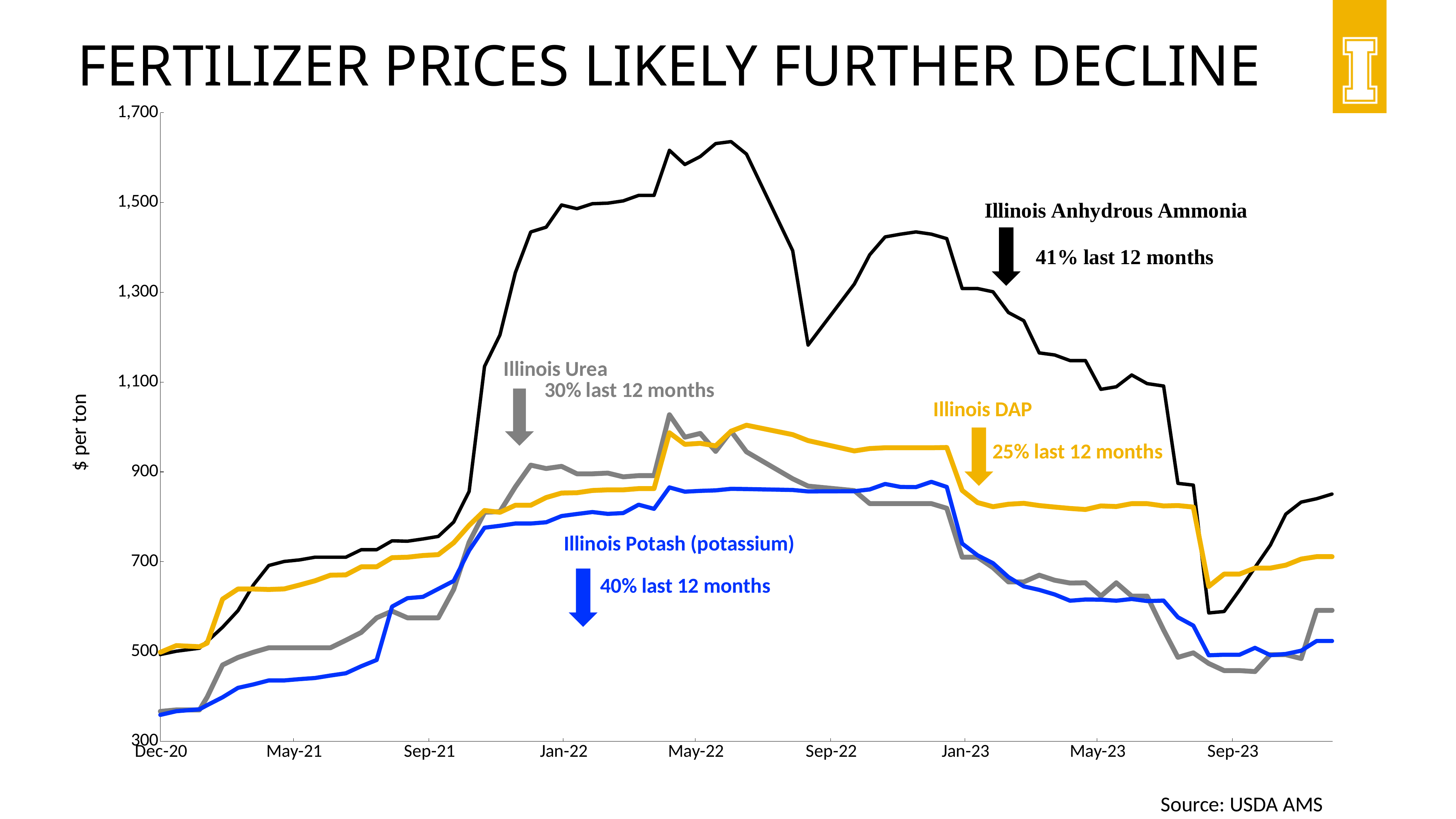
Does the Illinois Anhydrous Ammonia price rise or fall from Jan-23 to Sep-23? fall How many fertilizer price series are plotted on the chart? 4 At Dec-20, which is higher, Illinois DAP or Illinois Potash (potassium)? Illinois DAP What kind of chart is shown on the slide? line chart Is the Illinois Anhydrous Ammonia price at May-22 greater or less than 1,500? greater Is the Illinois DAP price at May-22 greater or less than 900? greater What percentage decline over the last 12 months is annotated for Illinois Potash (potassium)? 40% Which series reaches the highest price on the chart? Illinois Anhydrous Ammonia What percentage decline over the last 12 months is annotated for Illinois Anhydrous Ammonia? 41% Is the Illinois Anhydrous Ammonia price at Sep-23 greater or less than 700? less At May-22, which is higher, Illinois Anhydrous Ammonia or Illinois DAP? Illinois Anhydrous Ammonia